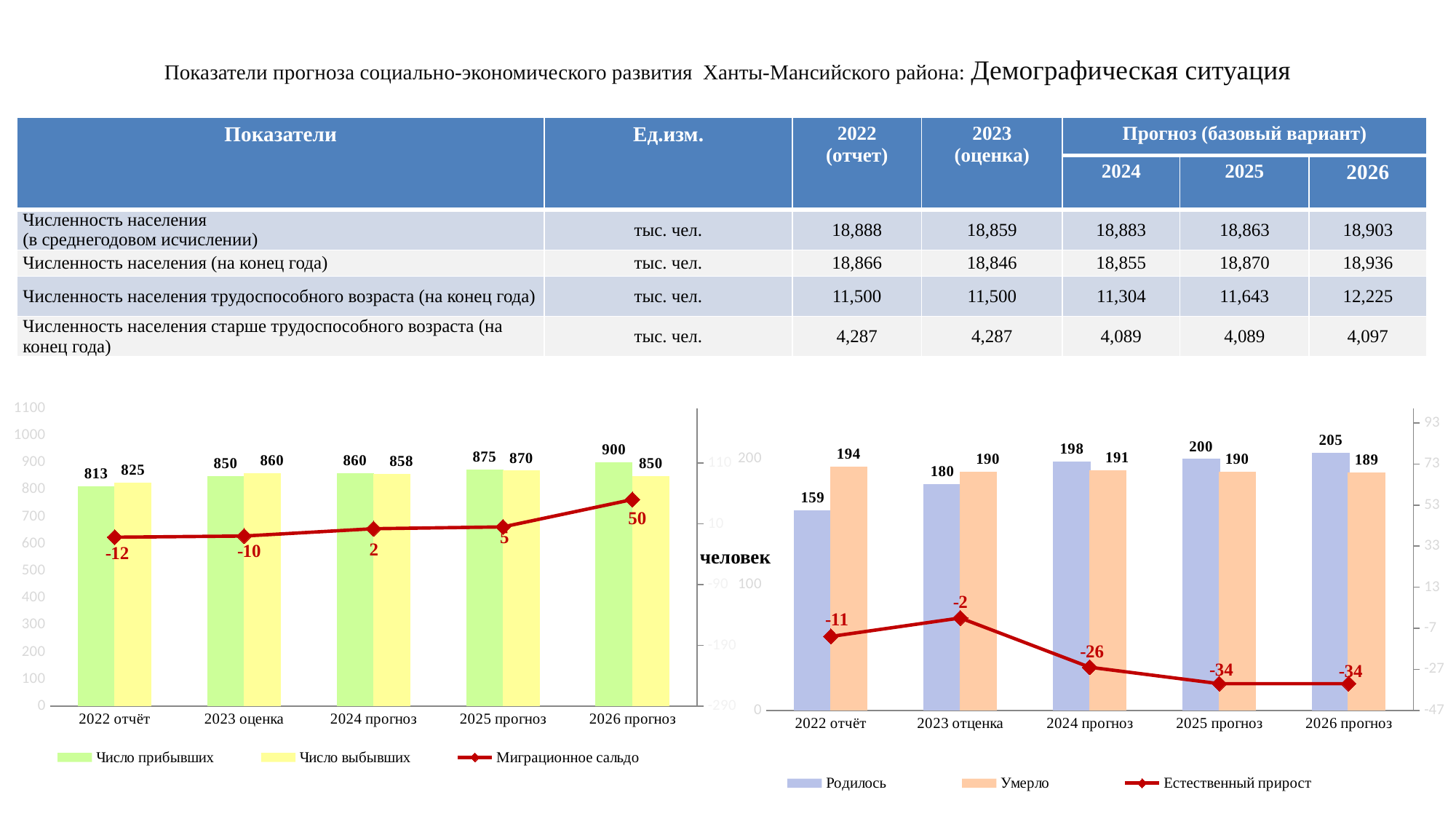
In the right chart, what is the Естественный прирост value for 2025 прогноз? -34 In the right chart, how many categories are shown on the x axis? 5 In the left chart, what is the value of Число выбывших for 2024 прогноз? 858 In the left chart, what is the difference between Число прибывших and Число выбывших for 2025 прогноз? 5 In the right chart, what is the value of Родилось for 2024 прогноз? 198 In the right chart, which year has the lowest value of Родилось? 2022 отчёт In the right chart, does the Родилось series rise or fall from 2022 отчёт to 2026 прогноз? rise In the right chart, what is the value of Умерло for 2022 отчёт? 194 In the left chart, what is the value of Число прибывших for 2022 отчёт? 813 In the left chart, what is the Миграционное сальдо value for 2026 прогноз? 50 In the left chart, how many series does the legend list? 3 In the left chart, which year has the highest value of Число прибывших? 2026 прогноз